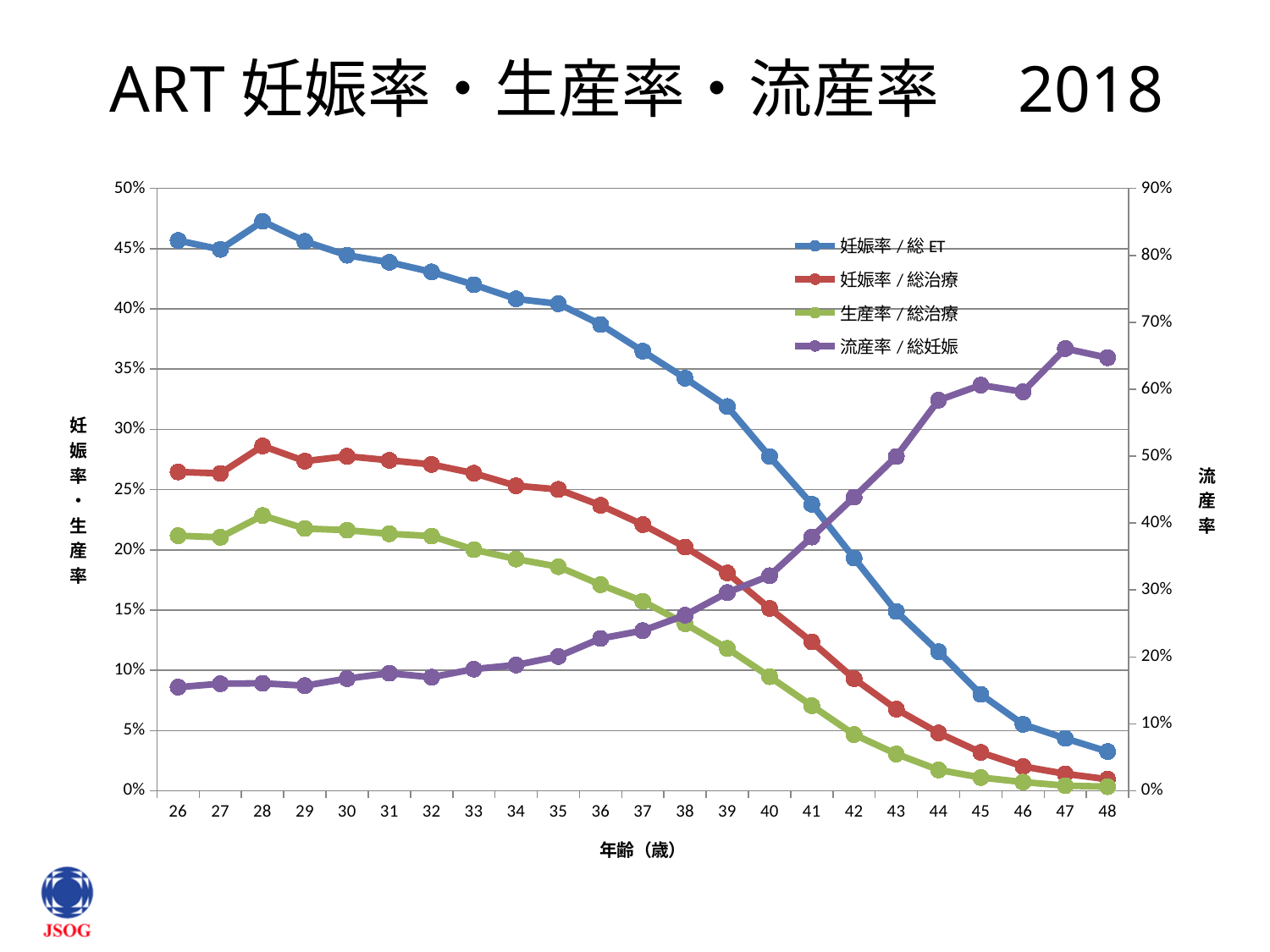
Does the 流産率 / 総妊娠 series generally rise or fall as age increases? rise What is the label of the x axis? 年齢（歳） At which age does the 流産率 / 総妊娠 series reach its highest value? 47 Is the value of 妊娠率 / 総 ET at age 26 greater or less than 40%? greater What kind of chart is shown on the slide? line chart Does the 妊娠率 / 総 ET series generally rise or fall as age increases? fall At which age does the 妊娠率 / 総 ET series reach its highest value? 28 Is the value of 生産率 / 総治療 at age 36 greater or less than 15%? greater At age 40, which is larger: 妊娠率 / 総 ET or 妊娠率 / 総治療? 妊娠率 / 総 ET At which age is the 妊娠率 / 総 ET series lowest? 48 How many age categories are plotted along the x axis? 23 How many series does the legend list? 4